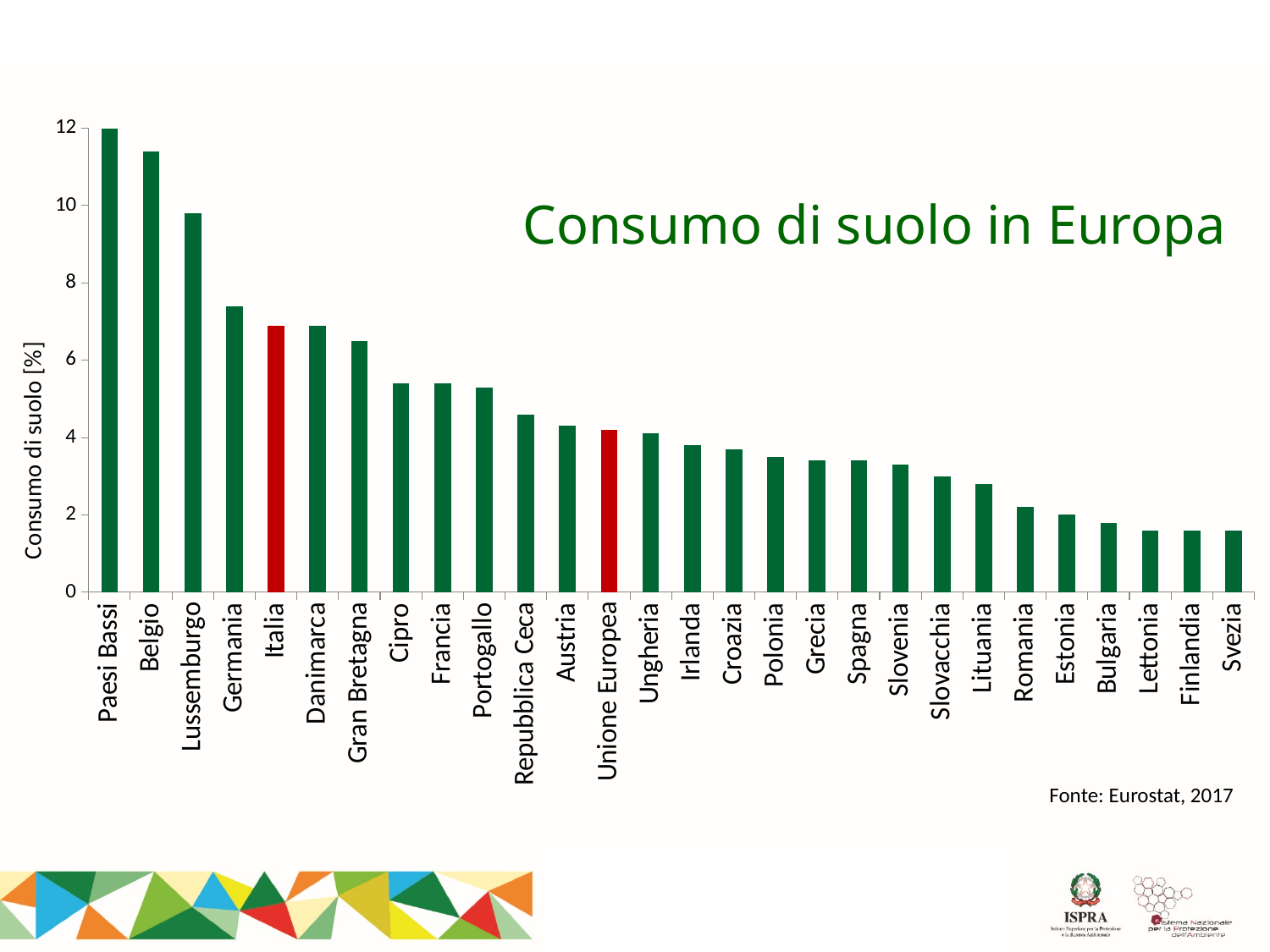
Is the value for Belgio greater or less than 10? greater What is the title of the chart? Consumo di suolo in Europa Is the value for Romania greater or less than 4? less Which two categories are drawn with red bars instead of green? Italia and Unione Europea Is the value for Lussemburgo greater or less than 8? greater Which category has the highest value? Paesi Bassi Which has the larger value, Germania or Gran Bretagna? Germania How many categories are plotted on the x axis? 28 What kind of chart is shown on the slide? Bar chart Do the values rise or fall moving from left to right along the x axis? Fall